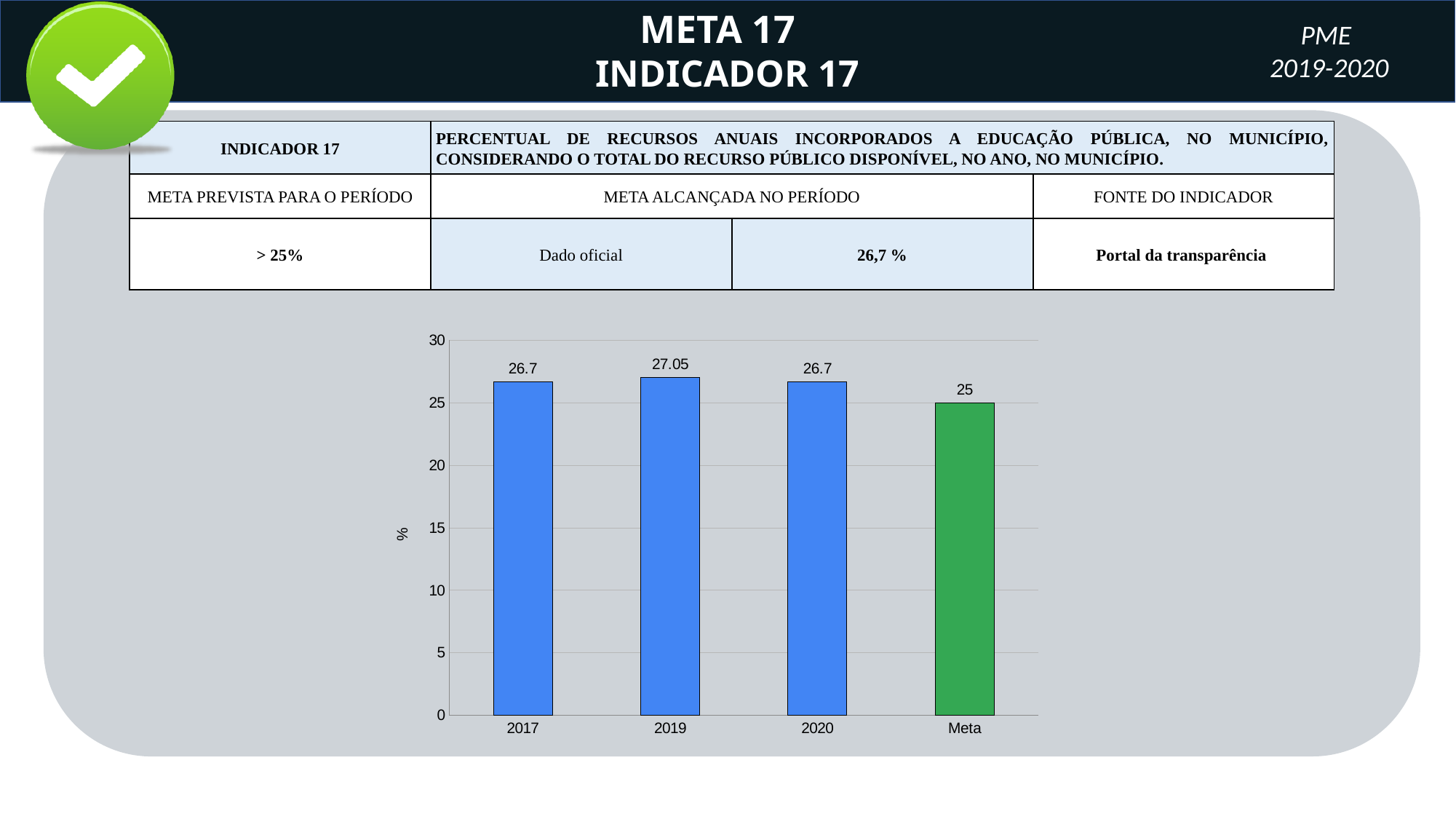
What is the value for 2017? 26.7 What is the value for 2019? 27.05 Is the value for 2020 greater or less than 25? greater Which category has the lowest value? Meta How many bars are shown in the chart? 4 What is the value for Meta? 25 Which is larger, the value for 2019 or the value for Meta? 2019 What is the difference between the value for 2019 and the value for Meta? 2.05 What is the label on the vertical axis of the chart? % Which category has the highest value? 2019 What is the difference between the value for 2020 and the value for Meta? 1.7 What kind of chart is shown on the slide? bar chart